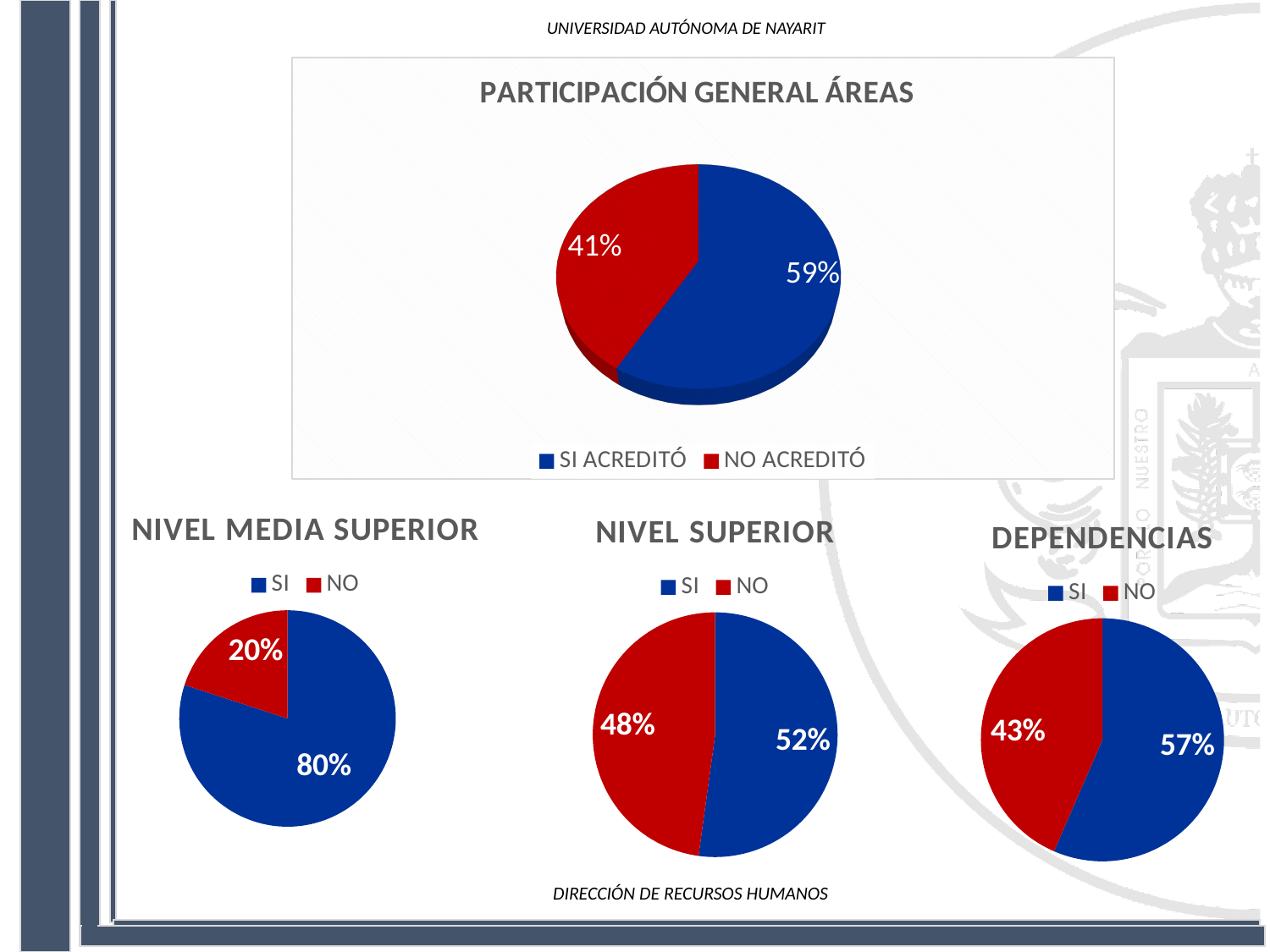
In the NIVEL SUPERIOR chart, what share is labelled for NO? 48% In the DEPENDENCIAS chart, what share is labelled for NO? 43% In the NIVEL MEDIA SUPERIOR chart, what share is labelled for SI? 80% What kind of chart is the PARTICIPACIÓN GENERAL ÁREAS chart? Pie chart In the PARTICIPACIÓN GENERAL ÁREAS chart, which slice is larger, SI ACREDITÓ or NO ACREDITÓ? SI ACREDITÓ In the DEPENDENCIAS chart, what is the difference between the SI and NO shares? 14% In the NIVEL MEDIA SUPERIOR chart, what is the difference between the SI and NO shares? 60% How many entries does the legend of the DEPENDENCIAS chart list? 2